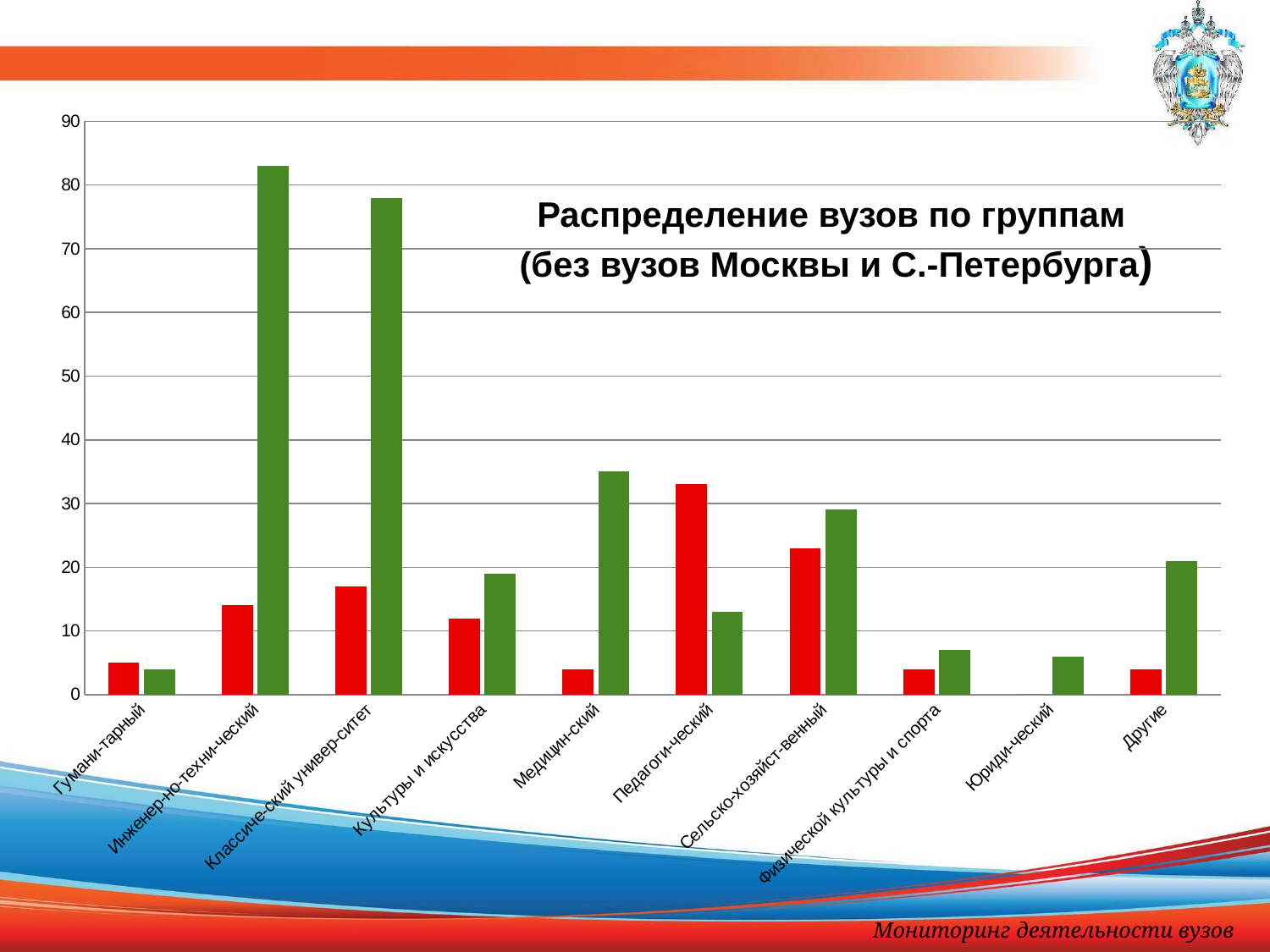
Which category has the tallest red bar? Педагогический What is the title of the chart? Распределение вузов по группам (без вузов Москвы и С.-Петербурга) Which green bar is taller: Инженерно-технический or Классический университет? Инженерно-технический Is the green bar for Медицинский greater or less than 30? greater Is the red bar for Педагогический greater or less than 30? greater Which category has the tallest green bar? Инженерно-технический Is the green bar for Классический университет greater or less than 70? greater Which category has the lowest red bar? Юридический For Педагогический, which bar is taller, the red or the green one? red How many categories are shown along the x axis of the chart? 10 What kind of chart is shown on the slide? bar chart